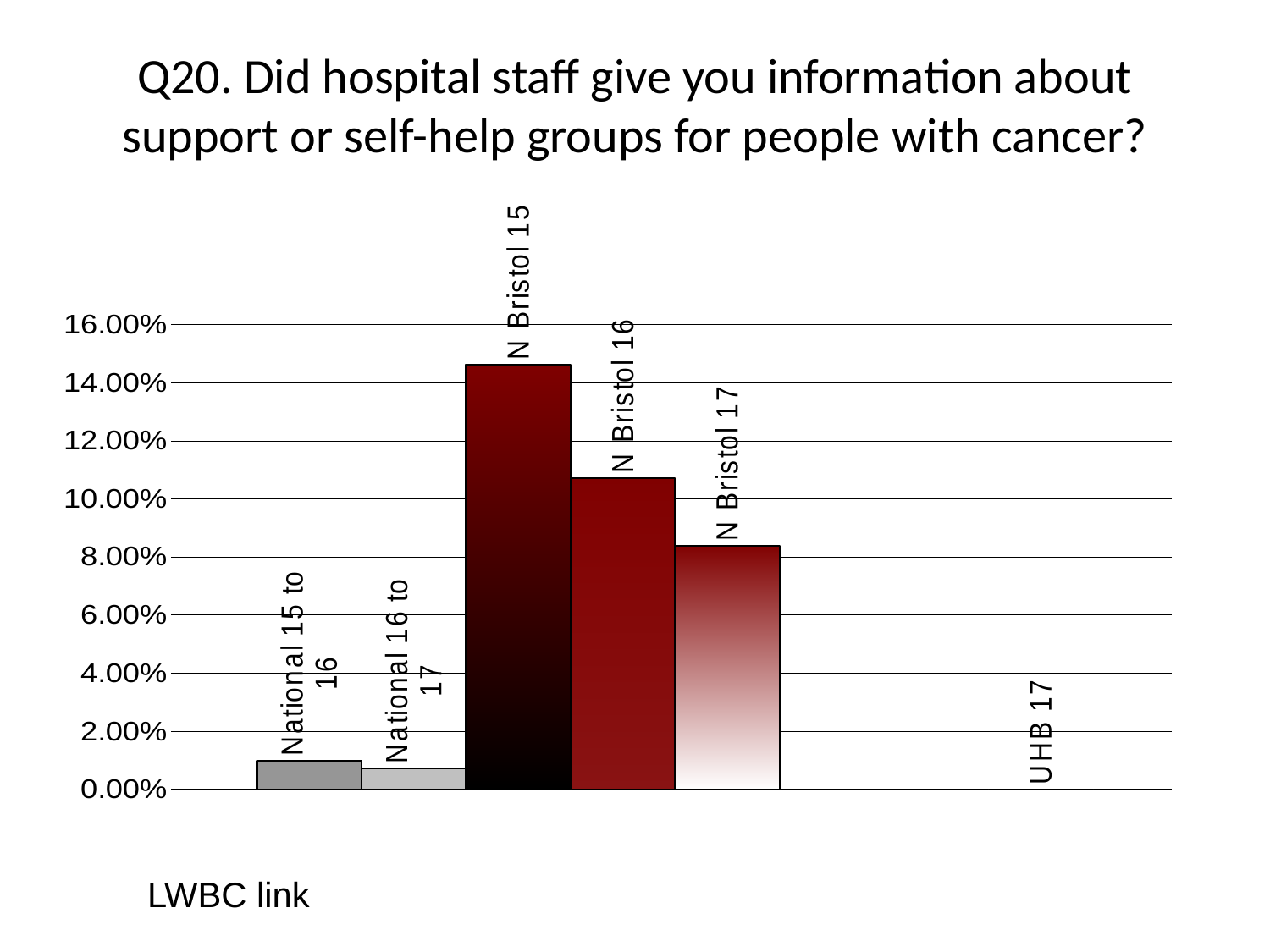
How many categories are labelled on the chart? 6 What is the title of the chart? Q20. Did hospital staff give you information about support or self-help groups for people with cancer? Is the value for N Bristol 17 greater or less than 8.00%? greater Is the value for N Bristol 16 greater or less than 10.00%? greater Do the values for N Bristol rise or fall from N Bristol 15 to N Bristol 17? fall Which category has the highest value? N Bristol 15 Is the value for N Bristol 17 greater or less than 10.00%? less Which is larger, the value for National 15 to 16 or the value for N Bristol 15? N Bristol 15 What kind of chart is shown on the slide? bar chart Which is larger, the value for N Bristol 16 or the value for N Bristol 17? N Bristol 16